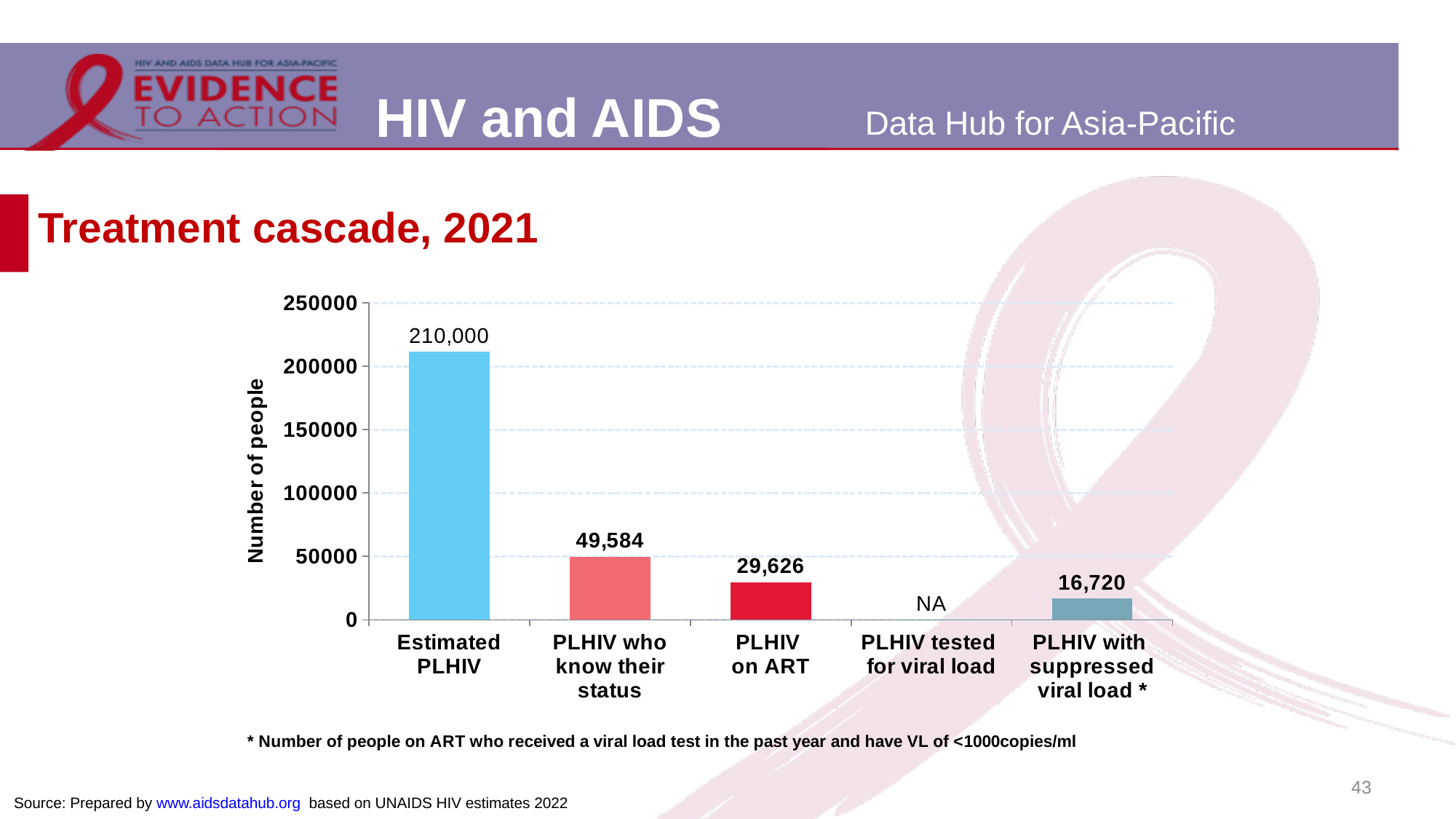
How many categories are shown on the x axis? 5 Which category with a plotted value has the lowest value? PLHIV with suppressed viral load * What is the difference between PLHIV who know their status and PLHIV on ART? 19,958 Which category has the highest value? Estimated PLHIV What is the value for Estimated PLHIV? 210,000 What is shown for PLHIV tested for viral load? NA What is the value for PLHIV who know their status? 49,584 Which is larger, PLHIV on ART or PLHIV with suppressed viral load? PLHIV on ART What kind of chart is this? Bar chart What is the value for PLHIV on ART? 29,626 What is the title of the chart? Treatment cascade, 2021 What is the value for PLHIV with suppressed viral load? 16,720